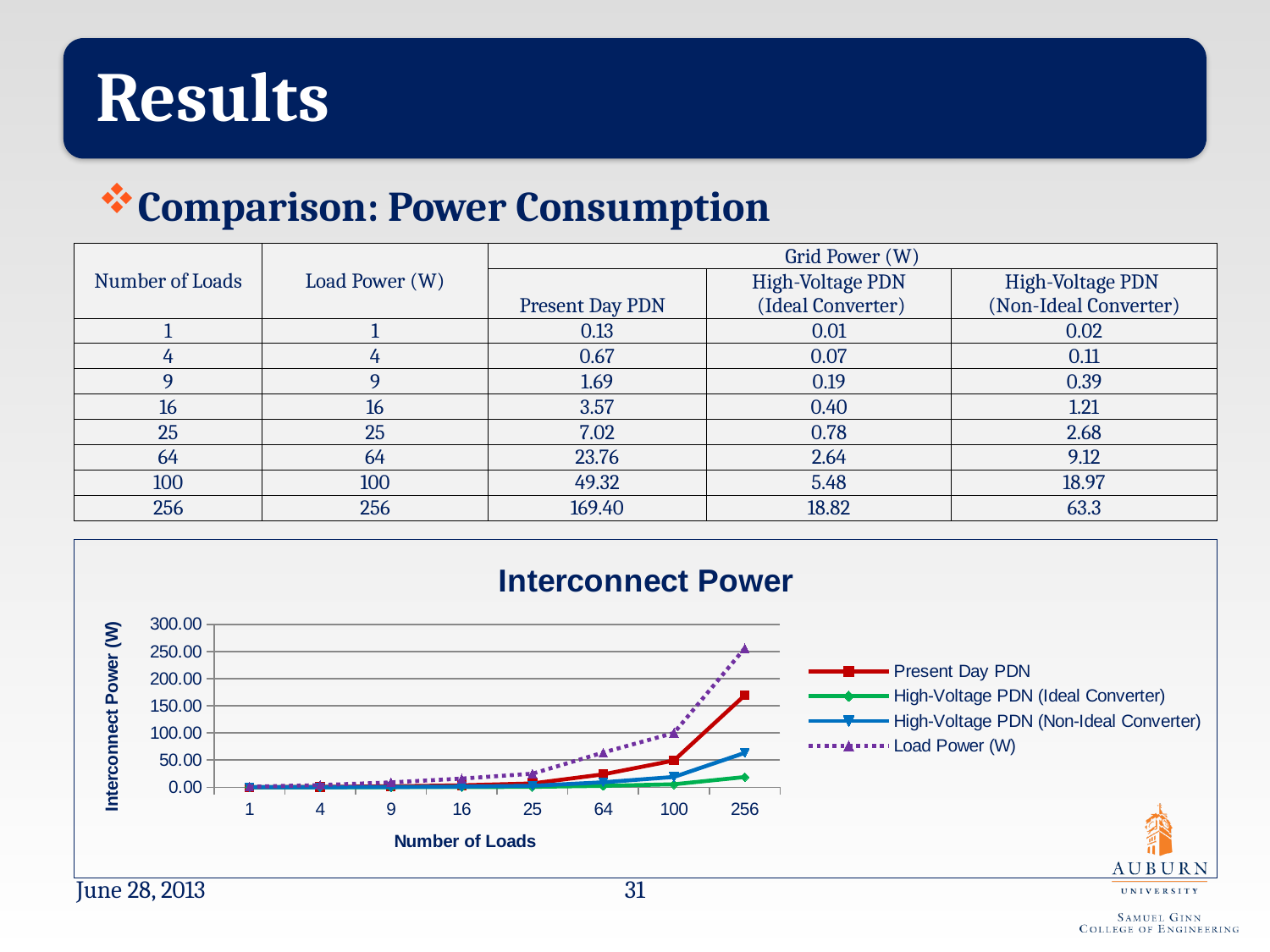
How many Number of Loads categories are plotted on the x axis of the Interconnect Power chart? 8 In the Interconnect Power chart, does the Present Day PDN series rise or fall as the number of loads increases? rises What is the Present Day PDN grid power at 256 loads, as shown in the table on the slide? 169.40 What kind of chart is the Interconnect Power chart? line chart What is the title of the chart on the slide? Interconnect Power In the Interconnect Power chart, is the Present Day PDN value at 256 loads greater or less than 200.00? less How many series does the legend of the Interconnect Power chart list? 4 In the Interconnect Power chart, is the High-Voltage PDN (Non-Ideal Converter) value at 256 loads greater or less than 100.00? less In the Interconnect Power chart, which series has the lowest value at 256 loads? High-Voltage PDN (Ideal Converter) In the Interconnect Power chart, which is larger at 100 loads: Present Day PDN or High-Voltage PDN (Non-Ideal Converter)? Present Day PDN In the Interconnect Power chart, is the Load Power (W) value at 256 loads greater or less than 200.00? greater In the Interconnect Power chart, which series has the highest value at 256 loads? Load Power (W)